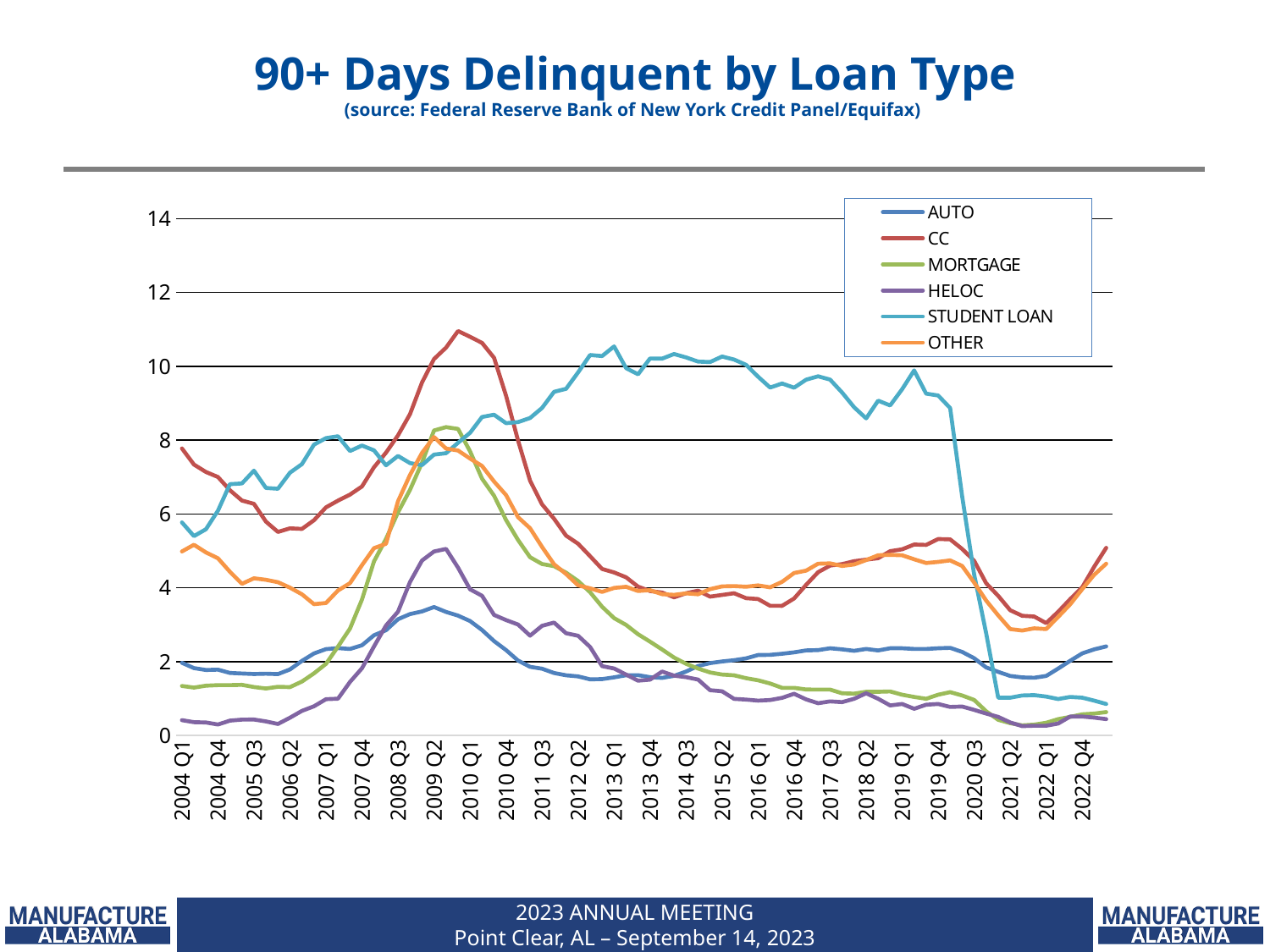
Does the STUDENT LOAN series rise or fall between 2019 Q4 and 2020 Q3? fall Which series is drawn in red in the legend? CC How many series does the legend list? 6 What kind of chart is shown on the slide? line chart Is the value for STUDENT LOAN at 2021 Q2 greater or less than 2? less What is the title of the chart? 90+ Days Delinquent by Loan Type Is the value for AUTO at 2009 Q2 greater or less than 4? less Is the value for CC at 2010 Q1 greater or less than 10? greater Which series has the highest value at 2016 Q1? STUDENT LOAN Which series has the lowest value at 2004 Q1? HELOC At 2013 Q1, which is larger: STUDENT LOAN or CC? STUDENT LOAN